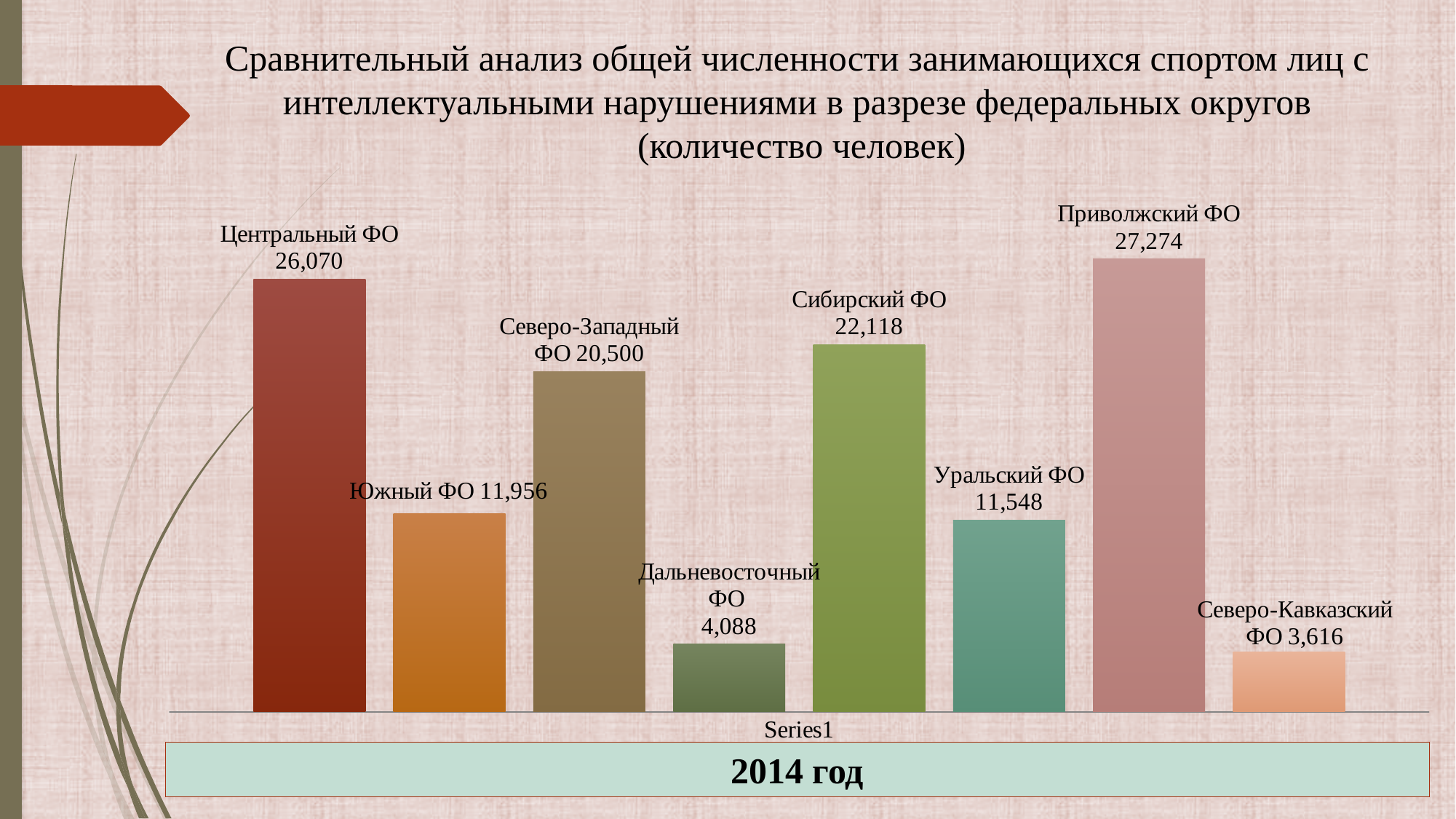
What is the value for Уральский ФО? 11,548 What is the value for Сибирский ФО? 22,118 How many federal districts (bars) are shown in the chart? 8 What is the difference between the values for Приволжский ФО and Центральный ФО? 1,204 Which federal district has the lowest value? Северо-Кавказский ФО What is the difference between the values for Дальневосточный ФО and Северо-Кавказский ФО? 472 What is the value for Северо-Кавказский ФО? 3,616 Which is larger, the value for Северо-Западный ФО or the value for Сибирский ФО? Сибирский ФО What is the value for Центральный ФО? 26,070 What kind of chart is shown on the slide? Bar chart What year is indicated below the chart? 2014 год Which federal district has the highest value? Приволжский ФО